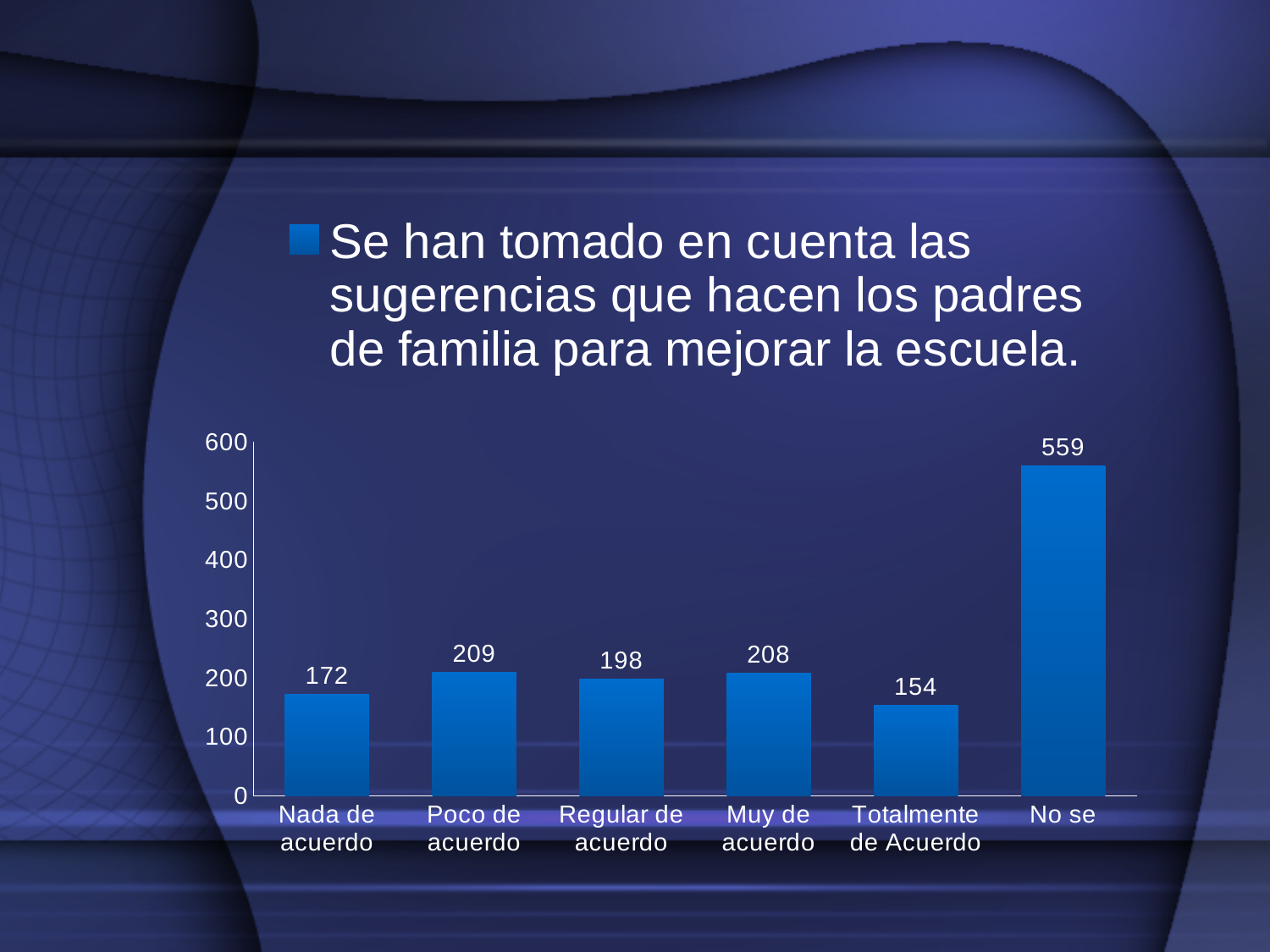
Which is larger, the value for "Poco de acuerdo" or the value for "Nada de acuerdo"? Poco de acuerdo What is the difference between the values for "No se" and "Poco de acuerdo"? 350 What is the difference between the values for "Nada de acuerdo" and "Totalmente de Acuerdo"? 18 What is the value for "Regular de acuerdo"? 198 What is the value for "Nada de acuerdo"? 172 What kind of chart is shown on the slide? Bar chart Which category has the highest value? No se What is the value for "No se"? 559 What is the value for "Totalmente de Acuerdo"? 154 Which category has the lowest value? Totalmente de Acuerdo What is the highest value shown on the vertical axis? 600 How many categories are shown on the x axis? 6